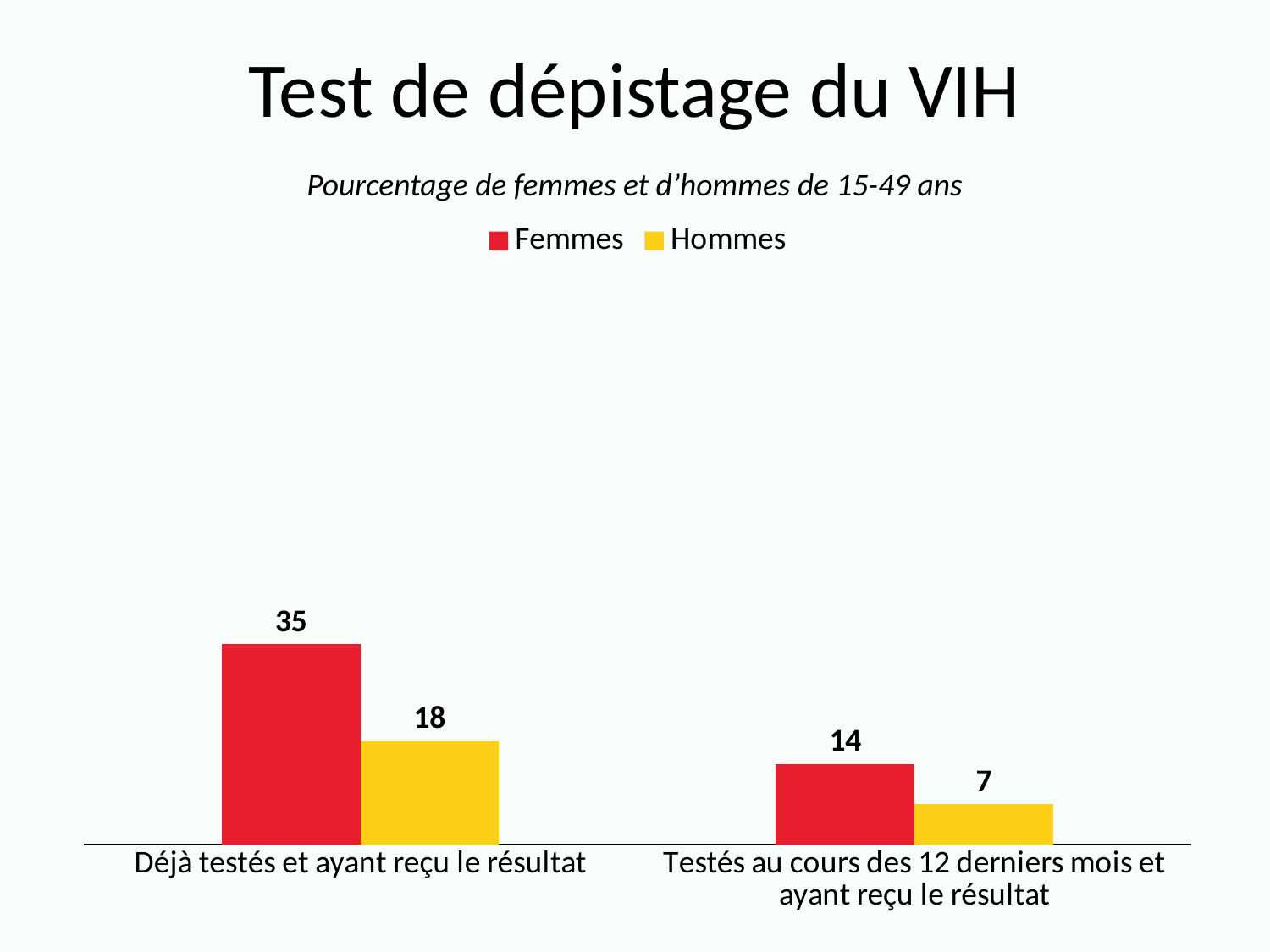
Which is larger: the Hommes value for 'Déjà testés et ayant reçu le résultat' or the Femmes value for 'Testés au cours des 12 derniers mois et ayant reçu le résultat'? Hommes, Déjà testés et ayant reçu le résultat What is the difference between the Femmes values for the two categories? 21 What kind of chart is shown on the slide? Bar chart What is the value for Hommes in the 'Déjà testés et ayant reçu le résultat' category? 18 What is the difference between the Femmes and Hommes values in the 'Déjà testés et ayant reçu le résultat' category? 17 How many series does the legend list? 2 How many categories are shown on the x axis? 2 What is the value for Femmes in the 'Testés au cours des 12 derniers mois et ayant reçu le résultat' category? 14 Which bar has the lowest value on the chart? Hommes, Testés au cours des 12 derniers mois et ayant reçu le résultat What is the value for Femmes in the 'Déjà testés et ayant reçu le résultat' category? 35 Which series has the highest value in the 'Déjà testés et ayant reçu le résultat' category? Femmes What is the value for Hommes in the 'Testés au cours des 12 derniers mois et ayant reçu le résultat' category? 7